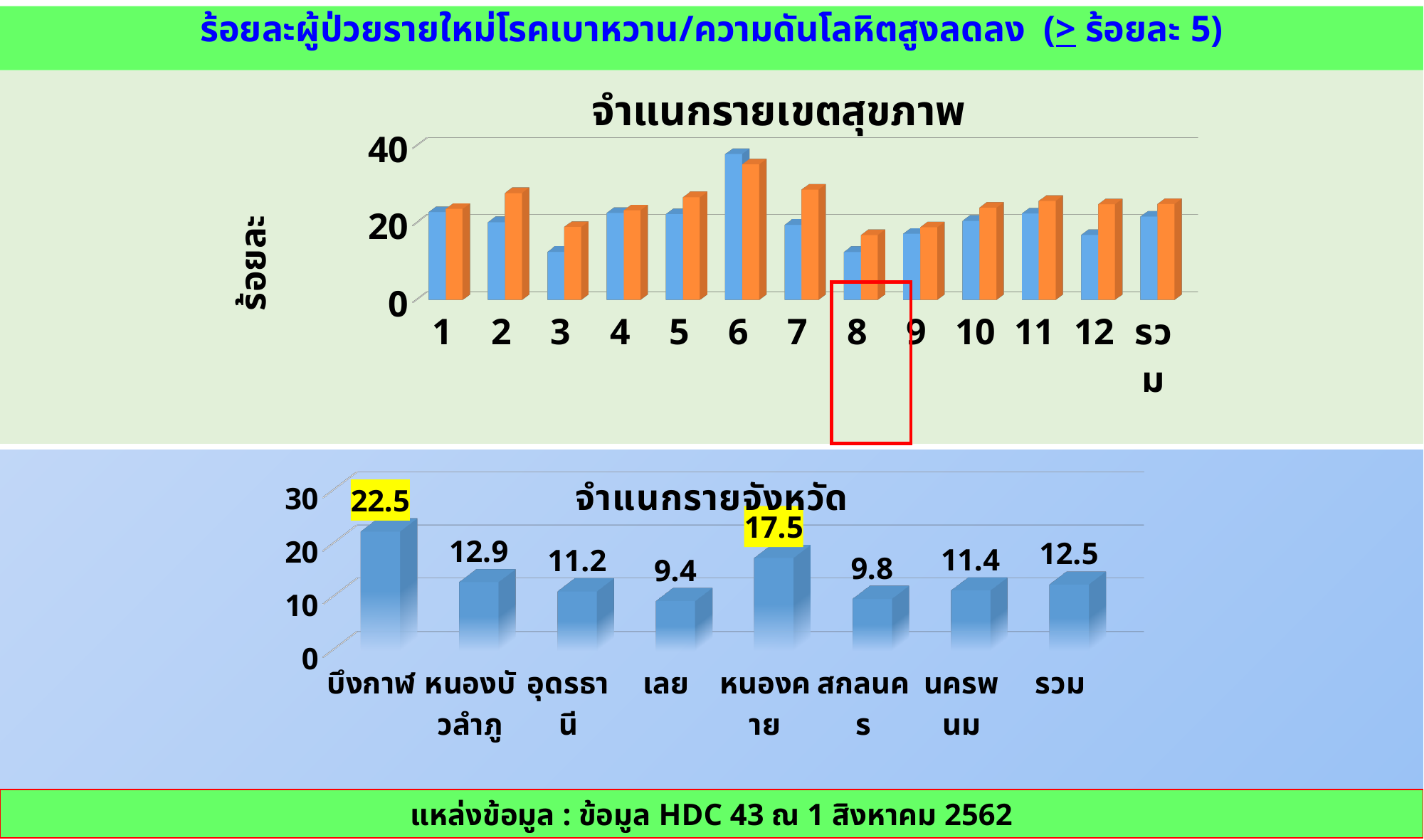
In the chart titled จำแนกรายจังหวัด, what is the difference between the values for บึงกาฬ and หนองคาย? 5.0 In the chart titled จำแนกรายจังหวัด, what is the value for รวม? 12.5 In the chart titled จำแนกรายจังหวัด, which category has the lowest value? เลย In the chart titled จำแนกรายเขตสุขภาพ, is the blue bar for category 3 greater or less than 20? less What kind of chart is the chart titled จำแนกรายเขตสุขภาพ? bar chart In the chart titled จำแนกรายเขตสุขภาพ, how many categories are shown on the x axis? 13 In the chart titled จำแนกรายจังหวัด, which is larger, the value for หนองบัวลำภู or the value for นครพนม? หนองบัวลำภู In the chart titled จำแนกรายจังหวัด, what is the value for บึงกาฬ? 22.5 In the chart titled จำแนกรายจังหวัด, how many categories are shown on the x axis? 8 In the chart titled จำแนกรายจังหวัด, which province has the highest value? บึงกาฬ In the chart titled จำแนกรายจังหวัด, what is the value for หนองคาย? 17.5 In the chart titled จำแนกรายเขตสุขภาพ, is the blue bar for category 6 greater or less than 30? greater